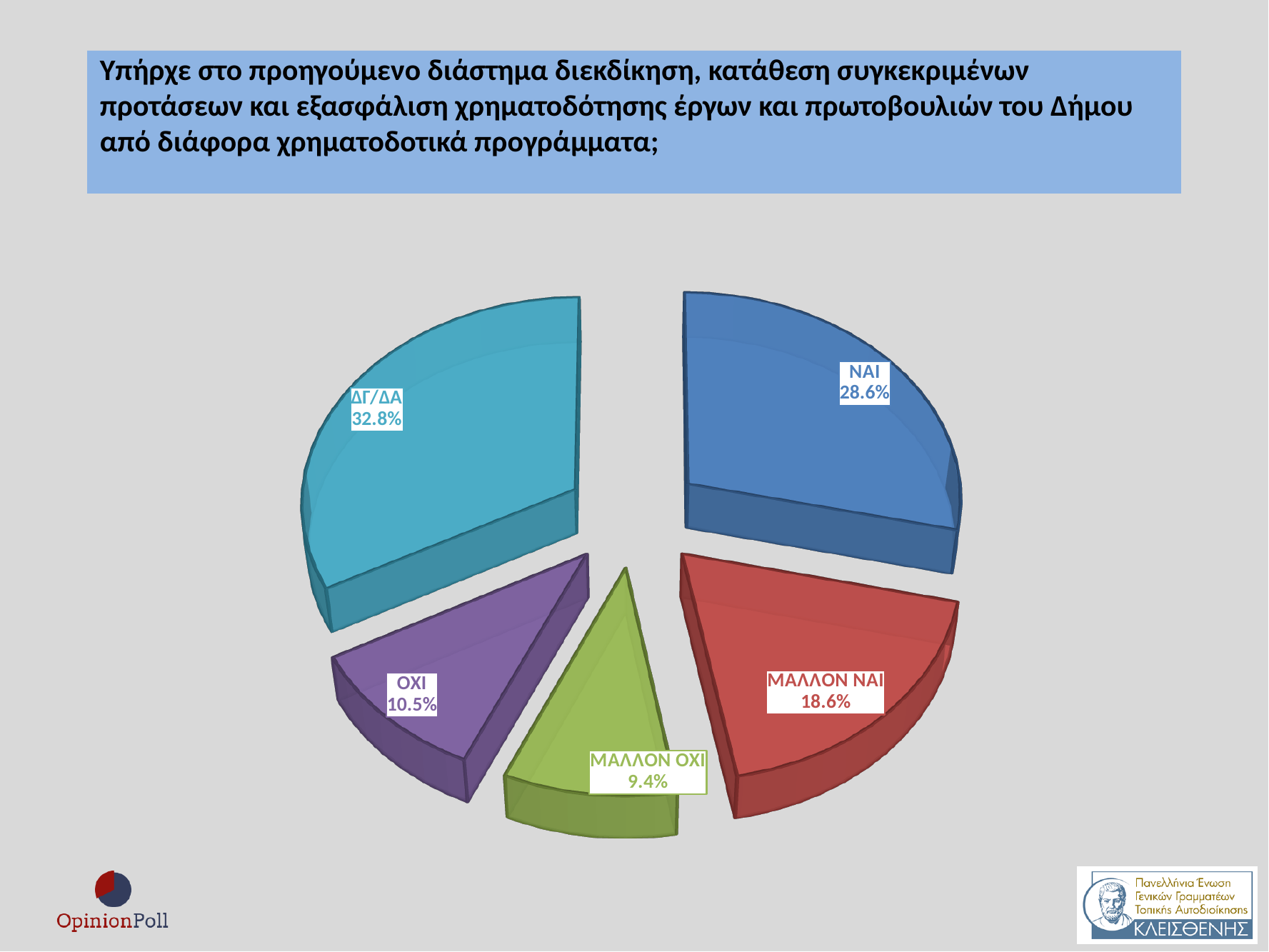
What is the difference in percentage points between ΝΑΙ and ΜΑΛΛΟΝ ΝΑΙ? 10.0 What percentage is shown for ΜΑΛΛΟΝ ΟΧΙ? 9.4% What type of chart is shown on the slide? Pie chart Which category has the largest slice of the pie? ΔΓ/ΔΑ What value is labelled on the ΟΧΙ slice? 10.5% What is the share for ΔΓ/ΔΑ in the pie chart? 32.8% How many slices does the pie chart have? 5 What colour is the ΜΑΛΛΟΝ ΝΑΙ slice? Red Which is larger, the share for ΟΧΙ or the share for ΜΑΛΛΟΝ ΟΧΙ? ΟΧΙ What is the combined share of ΝΑΙ and ΜΑΛΛΟΝ ΝΑΙ? 47.2% What percentage of respondents answered ΝΑΙ? 28.6% Which category has the smallest slice of the pie? ΜΑΛΛΟΝ ΟΧΙ